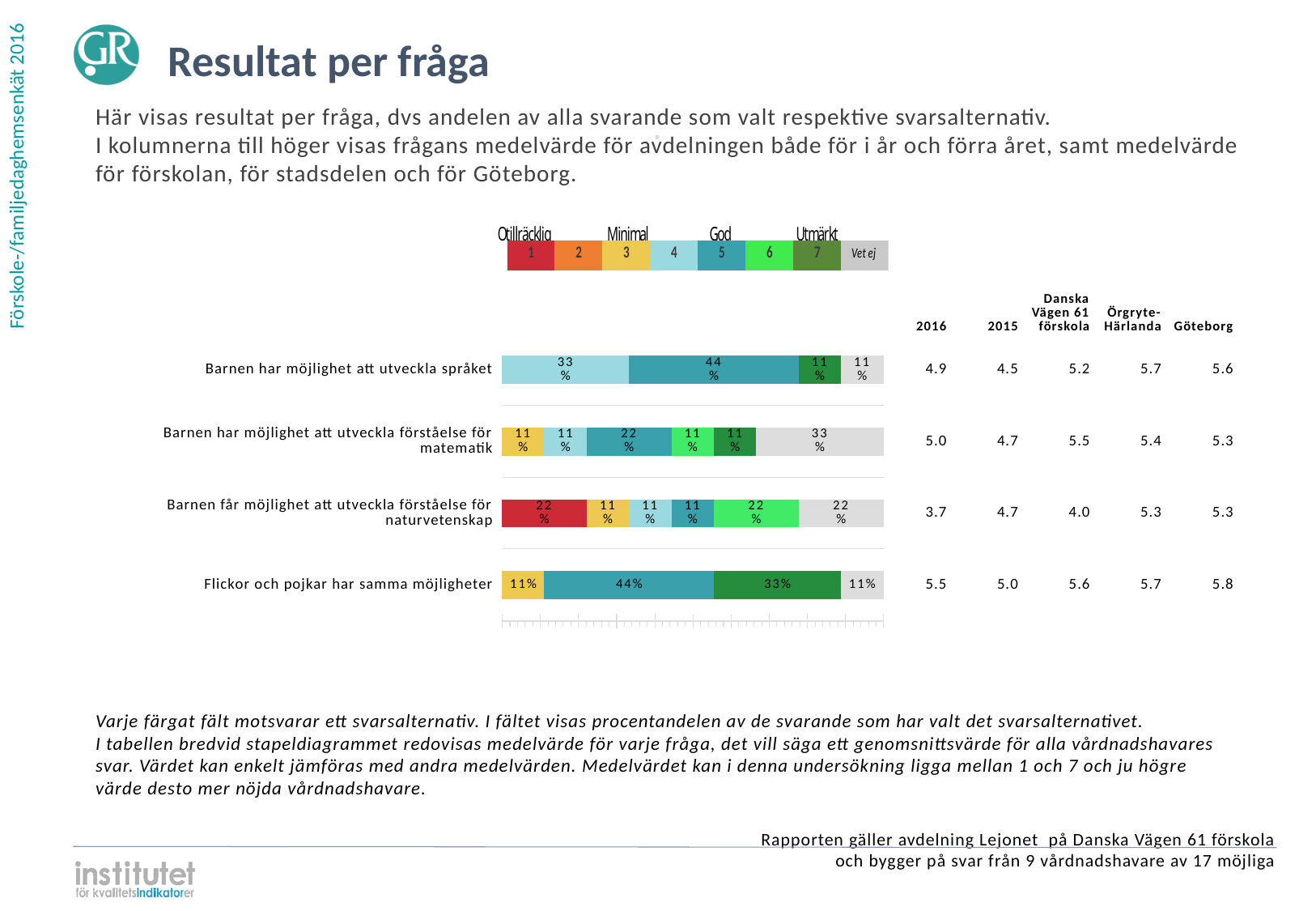
Which question has the lowest mean value in the 2016 column? Barnen får möjlighet att utveckla förståelse för naturvetenskap What percentage chose option 7 (Utmärkt, dark green) for 'Flickor och pojkar har samma möjligheter'? 33% How many response options does the legend above the chart list, including 'Vet ej'? 8 What is the difference between the 2015 and 2016 mean values for 'Barnen får möjlighet att utveckla förståelse för naturvetenskap'? 1.0 How many questions (categories) are shown in the bar chart? 4 Which question has the highest mean value in the 2016 column? Flickor och pojkar har samma möjligheter For 'Barnen har möjlighet att utveckla språket', which is larger: the share choosing option 4 (light blue) or the share choosing option 5 (teal)? Option 5 (teal), 44% What percentage of respondents chose option 5 (God, teal) for 'Barnen har möjlighet att utveckla språket'? 44% What kind of chart is used to show the results per question? Stacked bar chart What percentage chose 'Vet ej' for 'Barnen har möjlighet att utveckla förståelse för matematik'? 33% What percentage chose option 1 (Otillräcklig, red) for 'Barnen får möjlighet att utveckla förståelse för naturvetenskap'? 22% What label does the legend give to response option 7? Utmärkt